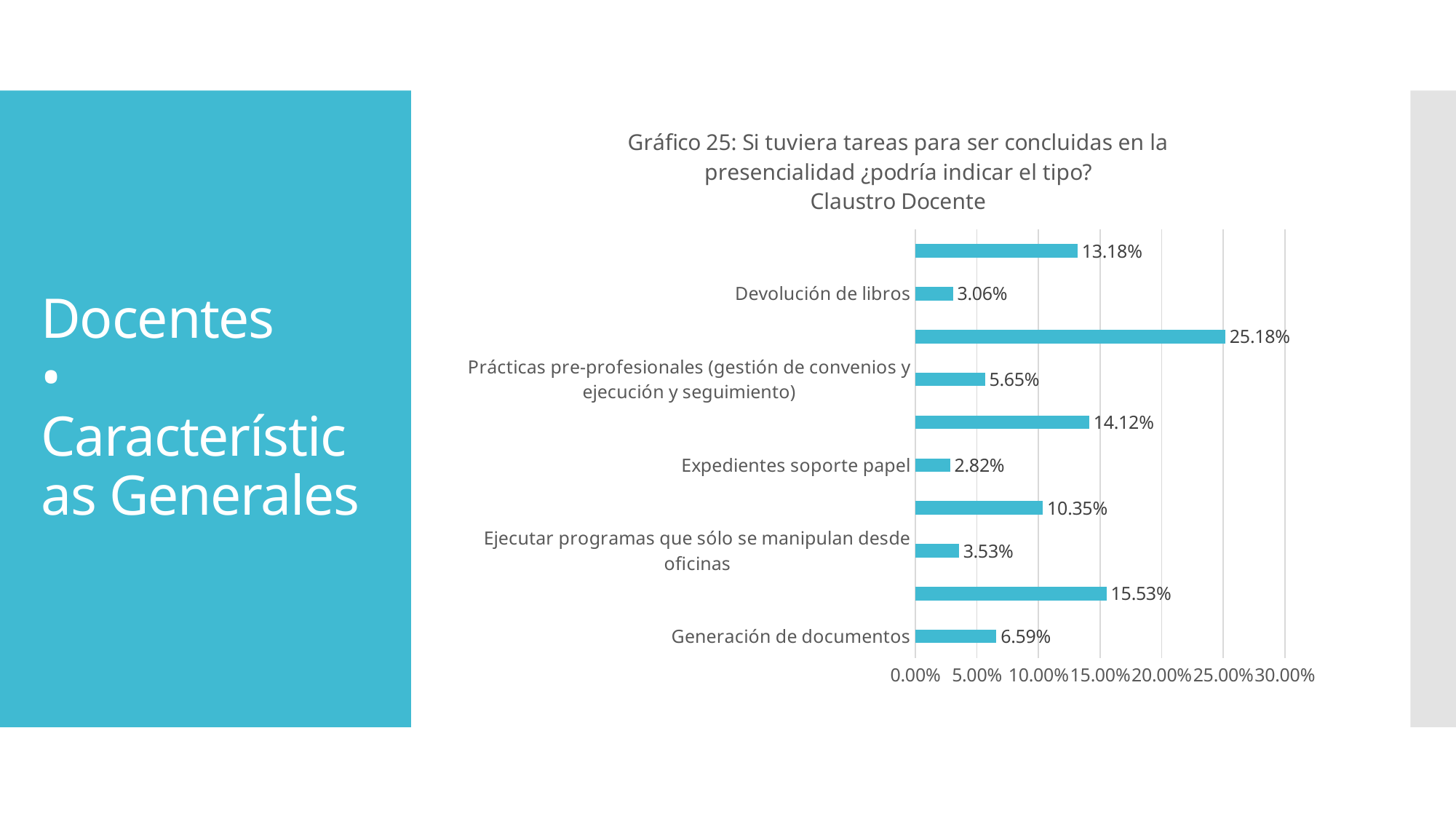
What is the value for Prácticas pre-profesionales (gestión de convenios y ejecución y seguimiento)? 5.65% What kind of chart is shown? Bar chart What is the maximum value shown on the x axis? 30.00% What is the value for Expedientes soporte papel? 2.82% Which is larger, Prácticas pre-profesionales or Ejecutar programas que sólo se manipulan desde oficinas? Prácticas pre-profesionales What is the difference between Generación de documentos and Devolución de libros? 3.53% Which labelled category has the lowest value? Expedientes soporte papel What is the value for Ejecutar programas que sólo se manipulan desde oficinas? 3.53% What is the value for Devolución de libros? 3.06% What is the largest value shown on the chart? 25.18% How many bars are plotted on the chart? 10 What is the value for Generación de documentos? 6.59%